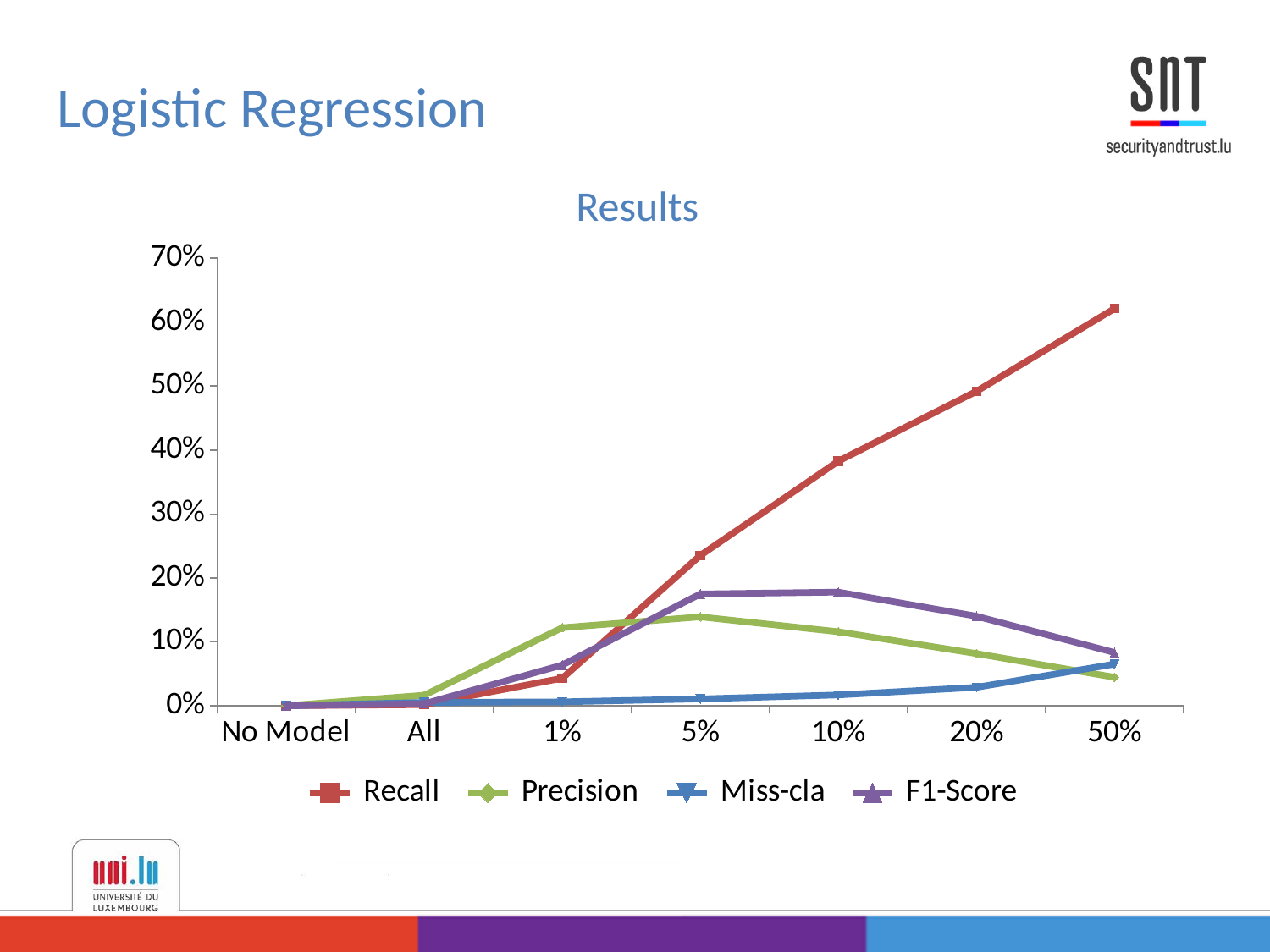
At the 5% category, which is larger: Recall or Miss-cla? Recall Is the Recall value at the 10% category greater or less than 30%? greater Which series has the highest value at the 50% category? Recall Does the Recall series rise or fall from the 1% category to the 50% category? rise How many categories are shown on the x axis of the "Results" chart? 7 At the 50% category, which is larger: Recall or Precision? Recall Is the Recall value at the 50% category greater or less than 50%? greater What kind of chart is shown under the title "Results"? line chart Is the Miss-cla value at the 20% category greater or less than 10%? less What is the title of the chart on the slide? Results How many series does the legend of the "Results" chart list? 4 Which series is drawn in green in the "Results" chart? Precision